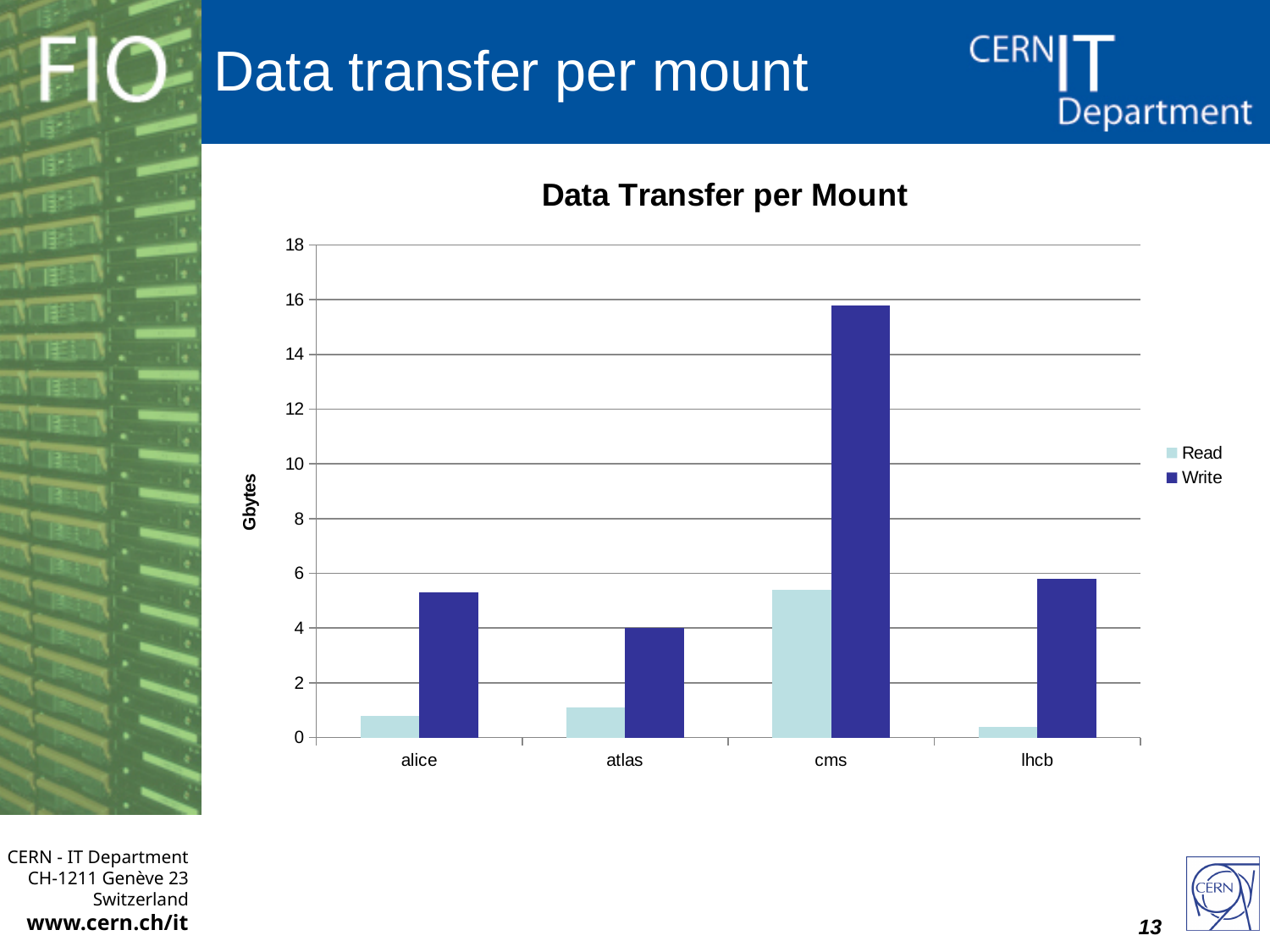
Which category has the lowest Read value? lhcb Is the Read value for alice greater or less than 2? less Which category has the highest Write value? cms Which category has the highest Read value? cms Which is larger, the Write value for lhcb or the Write value for atlas? lhcb How many series does the legend list? 2 What is the label on the y axis of the chart? Gbytes Is the Read value for cms greater or less than 4? greater How many categories are shown on the x axis of the chart? 4 Is the Write value for cms greater or less than 14? greater Which is larger, the Write value for cms or the Write value for alice? cms What kind of chart is shown on the slide? bar chart